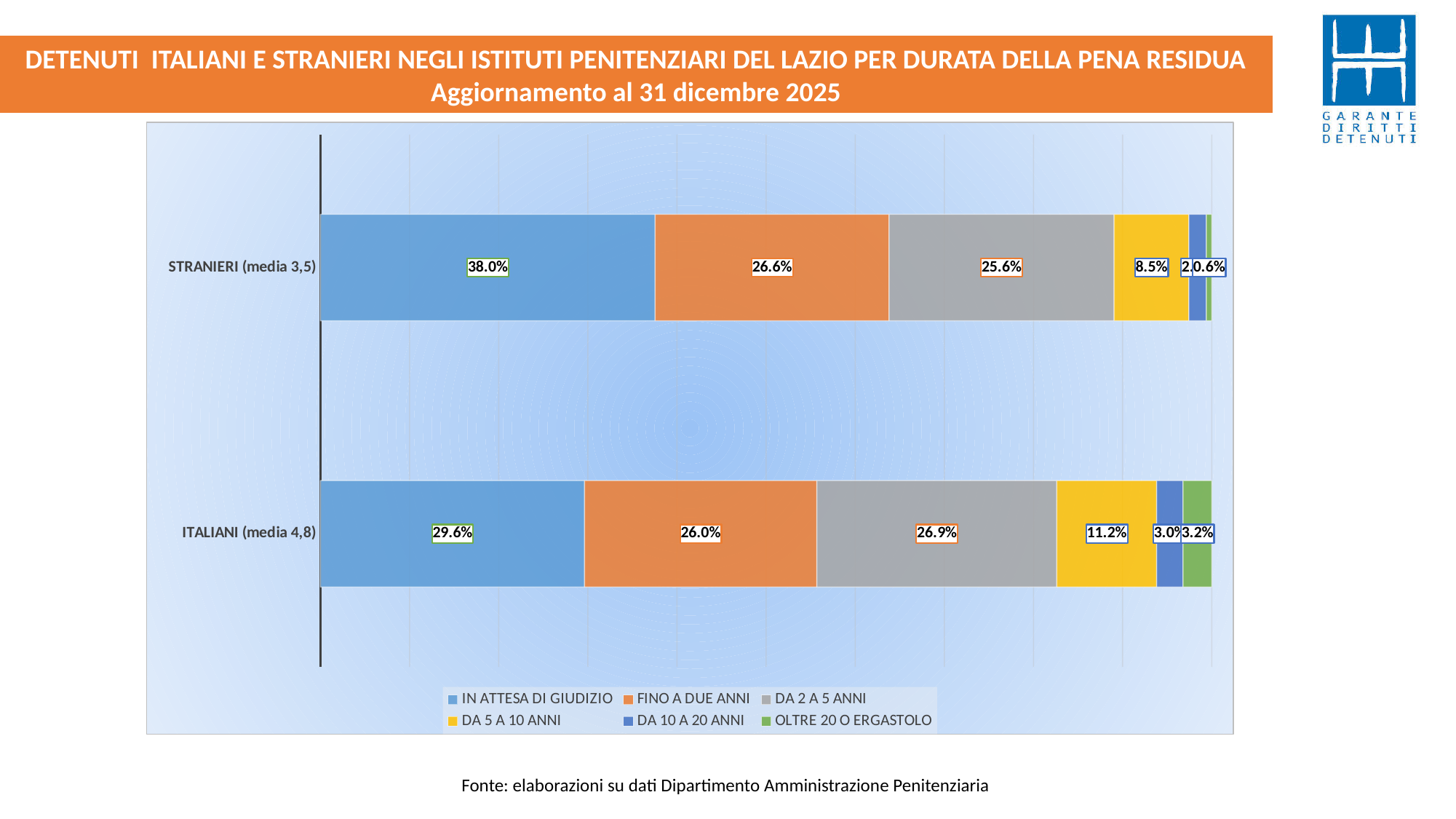
Which group has the larger DA 5 A 10 ANNI share, STRANIERI (media 3,5) or ITALIANI (media 4,8)? ITALIANI (media 4,8) Which segment is the smallest in the STRANIERI (media 3,5) bar? OLTRE 20 O ERGASTOLO Which colour represents FINO A DUE ANNI in the chart? Orange What is the difference between the IN ATTESA DI GIUDIZIO values for STRANIERI (media 3,5) and ITALIANI (media 4,8)? 8.4% Which segment is the largest in the ITALIANI (media 4,8) bar? IN ATTESA DI GIUDIZIO What is the value for DA 2 A 5 ANNI in the ITALIANI (media 4,8) bar? 26.9% How many series does the legend list? 6 How many bars (categories) are shown in the chart? 2 What is the value for IN ATTESA DI GIUDIZIO in the STRANIERI (media 3,5) bar? 38.0% What is the value for DA 5 A 10 ANNI in the ITALIANI (media 4,8) bar? 11.2% What type of chart is shown on the slide? Stacked bar chart What is the value for OLTRE 20 O ERGASTOLO in the STRANIERI (media 3,5) bar? 0.6%